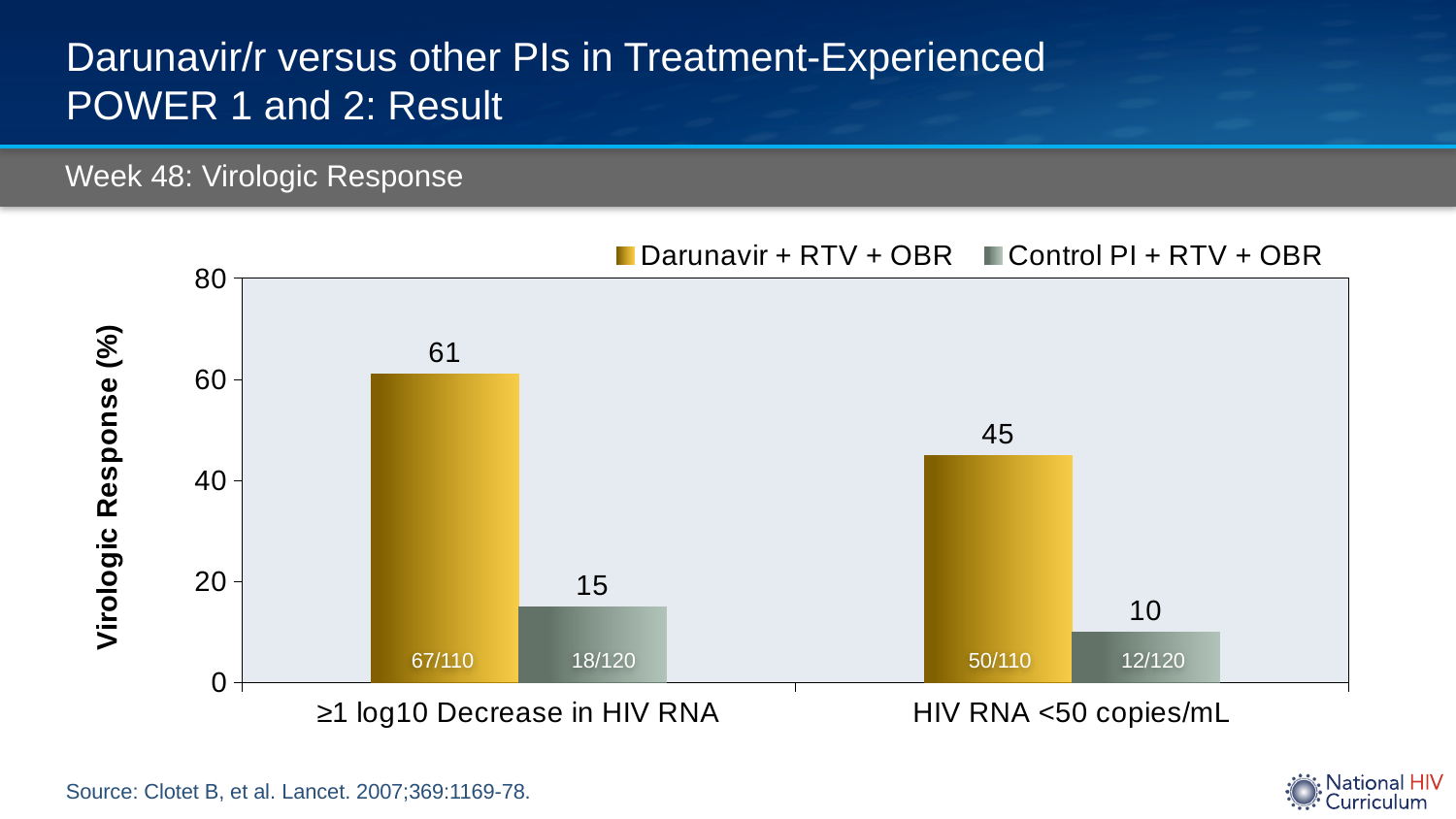
What kind of chart is shown on the slide? Bar chart Which bar has the highest value on the chart? Darunavir + RTV + OBR, ≥1 log10 Decrease in HIV RNA Which bar has the lowest value on the chart? Control PI + RTV + OBR, HIV RNA <50 copies/mL What is the virologic response for Control PI + RTV + OBR in the ≥1 log10 Decrease in HIV RNA category? 15 What is the virologic response for Control PI + RTV + OBR in the HIV RNA <50 copies/mL category? 10 How many categories are shown on the x axis? 2 How many series does the legend list? 2 What is the difference between the Darunavir + RTV + OBR and Control PI + RTV + OBR values in the HIV RNA <50 copies/mL category? 35 What is the virologic response for Darunavir + RTV + OBR in the HIV RNA <50 copies/mL category? 45 What is the virologic response for Darunavir + RTV + OBR in the ≥1 log10 Decrease in HIV RNA category? 61 Which series has the larger value in the ≥1 log10 Decrease in HIV RNA category? Darunavir + RTV + OBR What is the label of the y axis? Virologic Response (%)